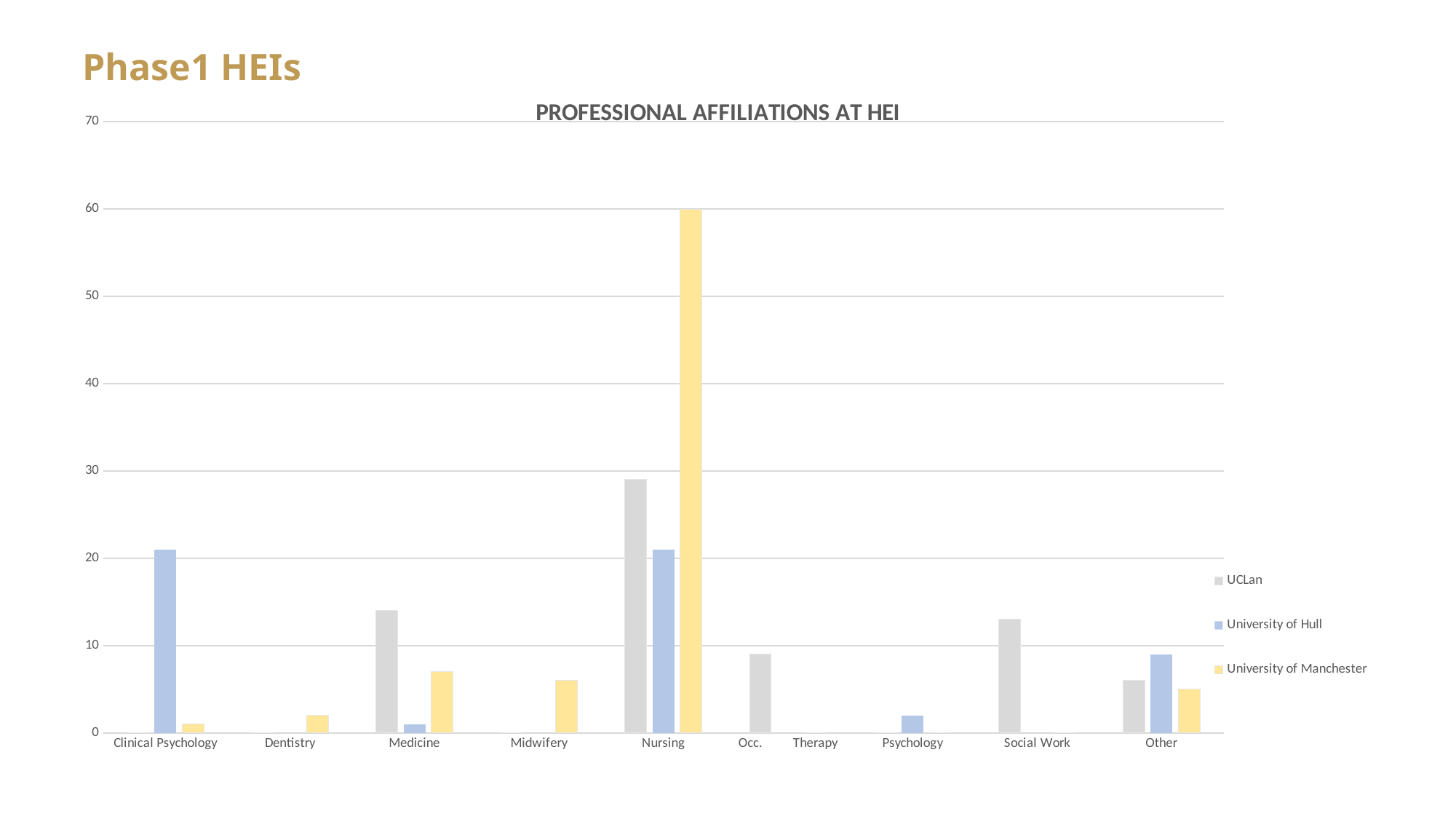
What is the value for University of Manchester in the Nursing category? 60 In the Nursing category, which is larger: UCLan or University of Hull? UCLan Which category has the highest UCLan value? Nursing What type of chart is shown on the slide? bar chart Is the University of Hull value for Clinical Psychology greater or less than 10? greater Which series is shown in yellow in the legend? University of Manchester How many categories are shown along the x axis? 9 Which category has the tallest bar for University of Manchester? Nursing In the Other category, which is larger: University of Hull or UCLan? University of Hull What is the title of the chart? PROFESSIONAL AFFILIATIONS AT HEI How many series does the legend list? 3 Is the UCLan value for Medicine greater or less than 10? greater